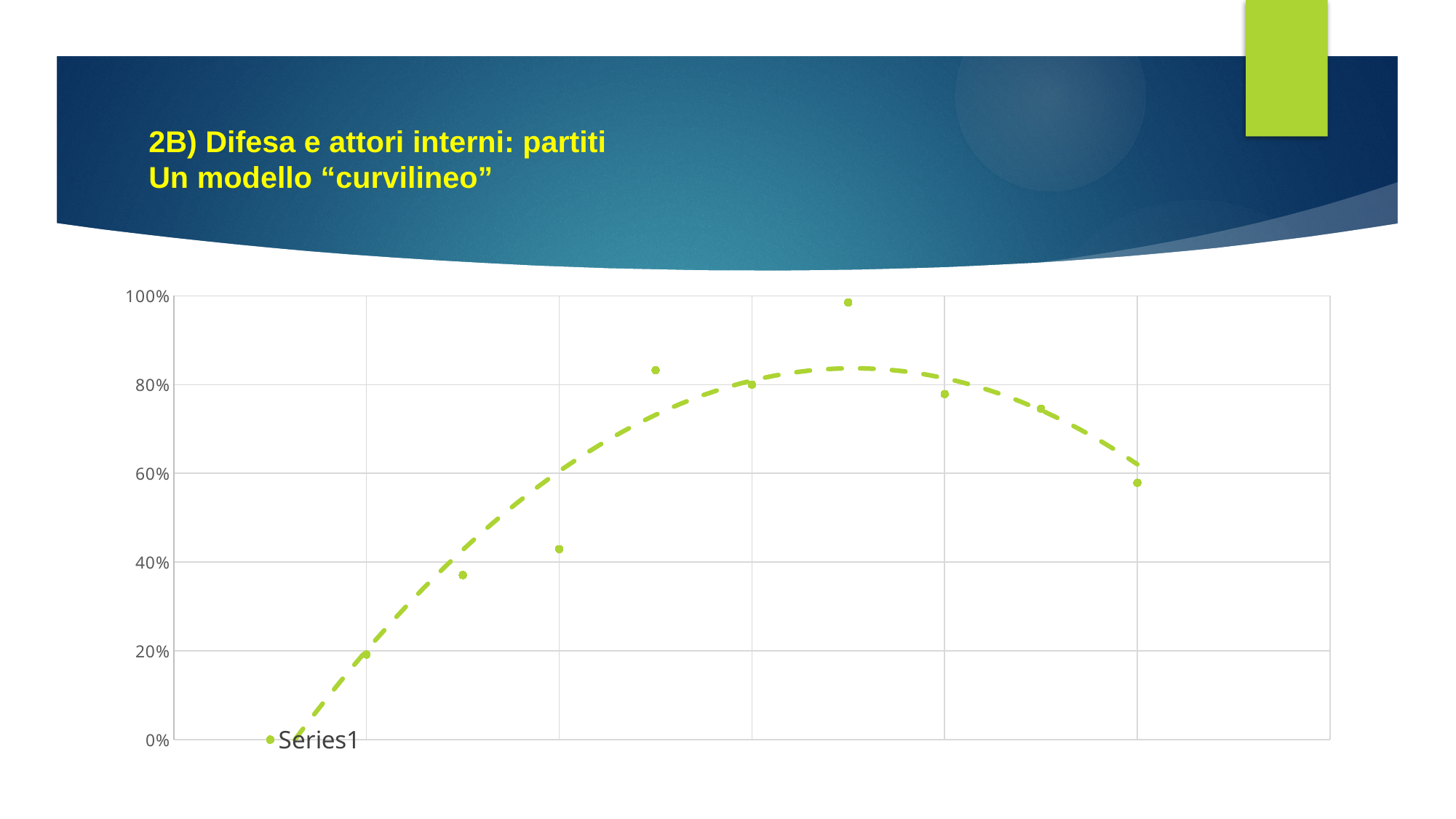
Which is higher, the leftmost data point or the rightmost data point? the rightmost data point Does the dashed trendline rise or fall at the right end of the chart? fall Is the highest data point on the chart greater or less than 90%? greater Do the values rise or fall along the x axis overall? rise then fall How many data points are plotted on the chart? 10 Is the value of the rightmost data point greater or less than 80%? less What kind of chart is shown on the slide? scatter chart What is the name of the series shown on the chart? Series1 Is the value of the second data point from the left greater or less than 40%? less How many series does the chart show? 1 What is the highest value shown on the vertical axis? 100% What is the value of the leftmost data point on the chart? 0%